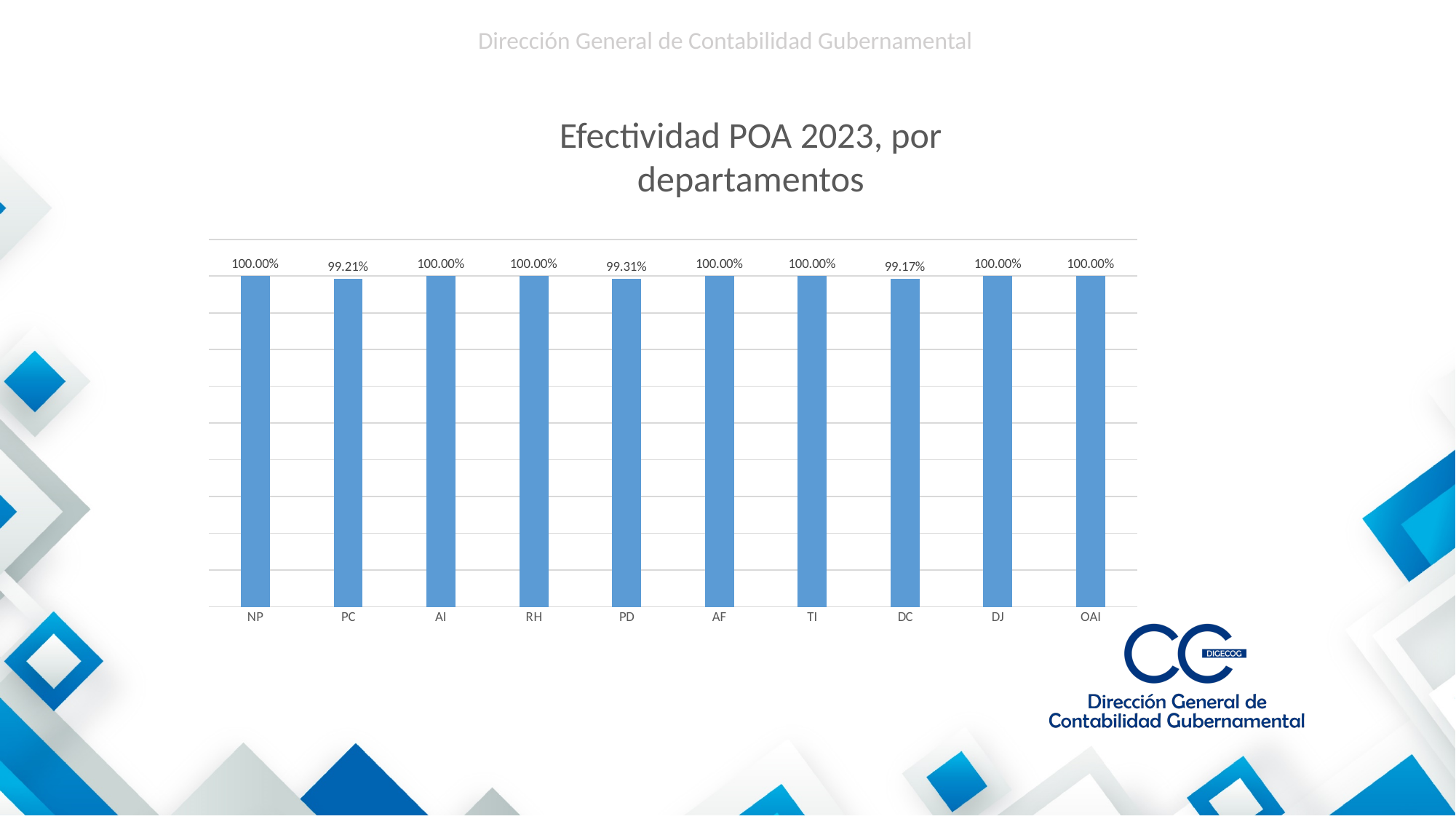
What is the title of the chart? Efectividad POA 2023, por departamentos Which is larger, the value for PD or the value for PC? PD How many departments are shown on the chart? 10 What is the difference between the values for PD and DC? 0.14% What kind of chart is shown on the slide? Bar chart What is the difference between the values for NP and PC? 0.79% What is the value for PC? 99.21% Which department has the lowest value? DC What is the value for DC? 99.17% What is the value for PD? 99.31% What is the value for RH? 100.00% Which is larger, the value for PC or the value for DC? PC